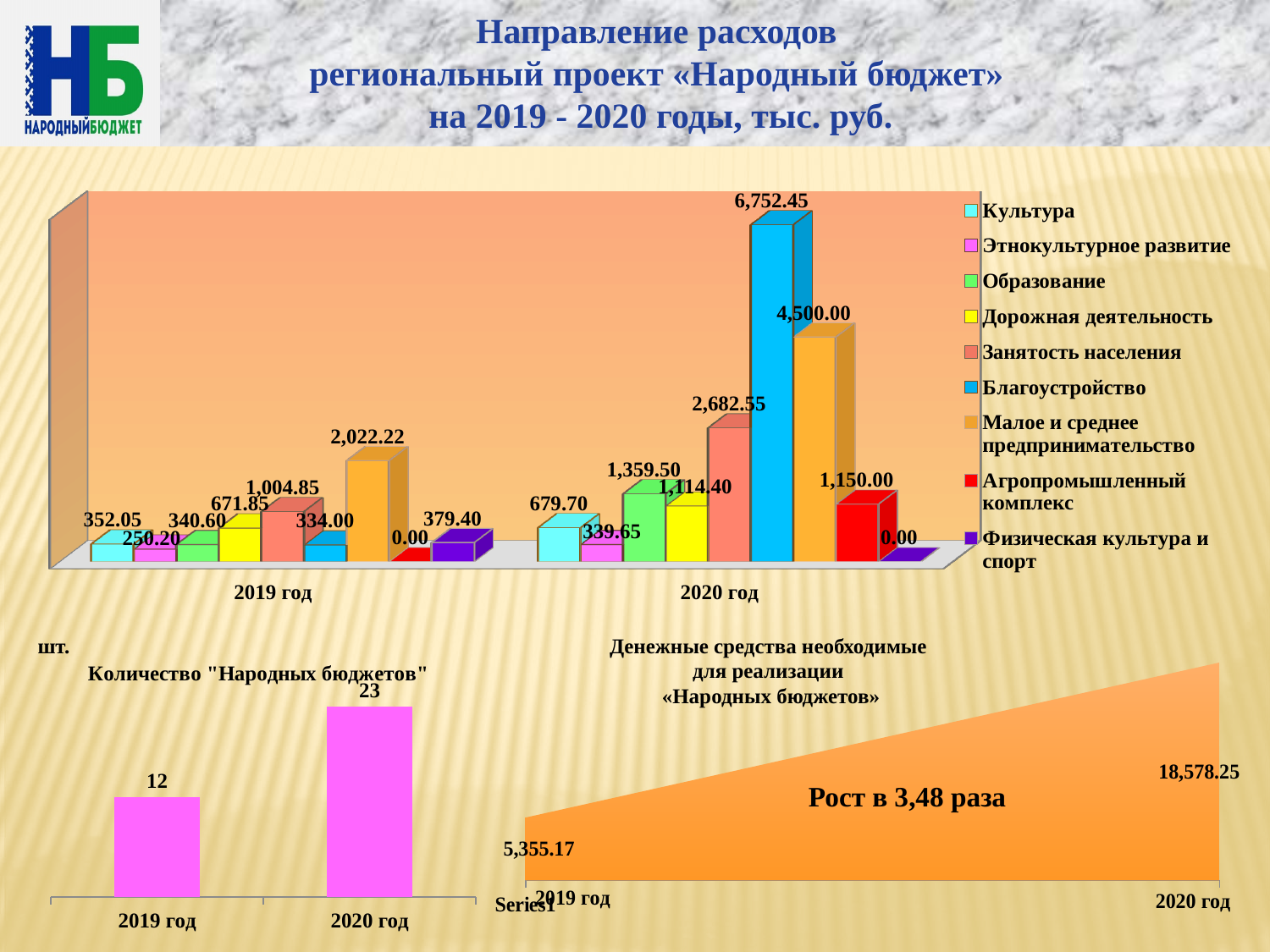
In the top chart 'Направление расходов', what is the value for Благоустройство in 2020 год? 6,752.45 In the top chart 'Направление расходов', what is the value for Малое и среднее предпринимательство in 2019 год? 2,022.22 In the top chart 'Направление расходов', which series has the highest value in 2020 год? Благоустройство In the top chart 'Направление расходов', which is larger in 2020 год: Образование or Дорожная деятельность? Образование In the bottom-left chart 'Количество "Народных бюджетов"', what is the value for 2020 год? 23 In the bottom-right chart 'Денежные средства необходимые для реализации «Народных бюджетов»', what is the value for 2019 год? 5,355.17 In the top chart 'Направление расходов', what colour represents Благоустройство in the legend? Blue How many series does the legend of the top chart 'Направление расходов' list? 9 In the top chart 'Направление расходов', which series has the lowest value in 2019 год? Агропромышленный комплекс In the bottom-left chart 'Количество "Народных бюджетов"', what is the difference between 2020 год and 2019 год? 11 In the top chart 'Направление расходов', what is the difference between the Культура values for 2020 год and 2019 год? 327.65 What kind of chart is the bottom-left chart 'Количество "Народных бюджетов"'? Bar chart